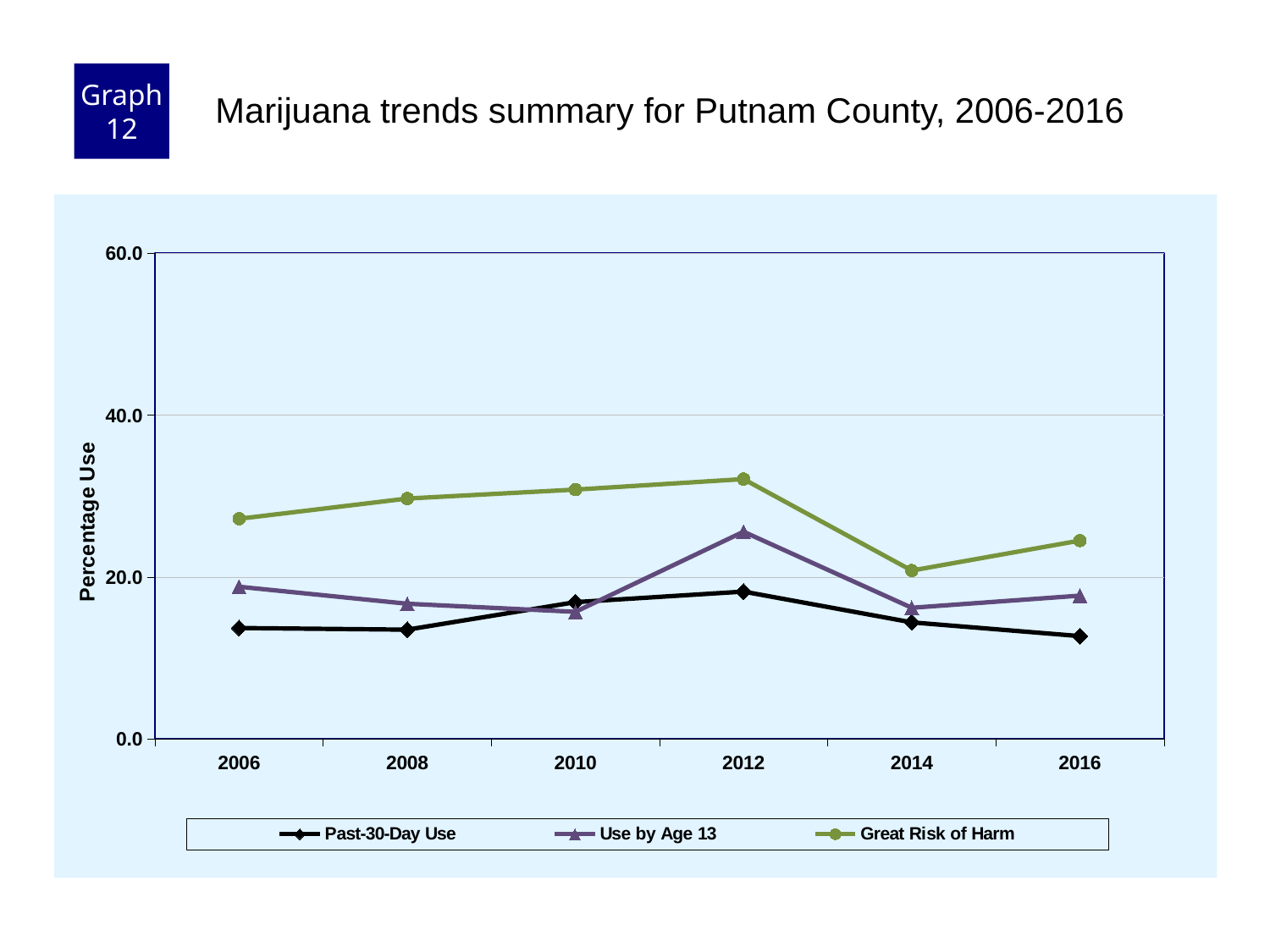
How many years are plotted along the x axis? 6 How many series does the legend list? 3 In which year is the Use by Age 13 series at its highest? 2012 Is the value for Past-30-Day Use in 2016 greater or less than 20.0? less Is the value for Great Risk of Harm in 2008 greater or less than 40.0? less What is the label on the y axis? Percentage Use In which year is the Great Risk of Harm series at its lowest? 2014 In 2012, which is larger: Use by Age 13 or Past-30-Day Use? Use by Age 13 What kind of chart is shown on the slide? line chart Which series has the highest value in 2012? Great Risk of Harm Does the Great Risk of Harm series rise or fall from 2006 to 2012? rise Is the value for Great Risk of Harm in 2012 greater or less than 20.0? greater